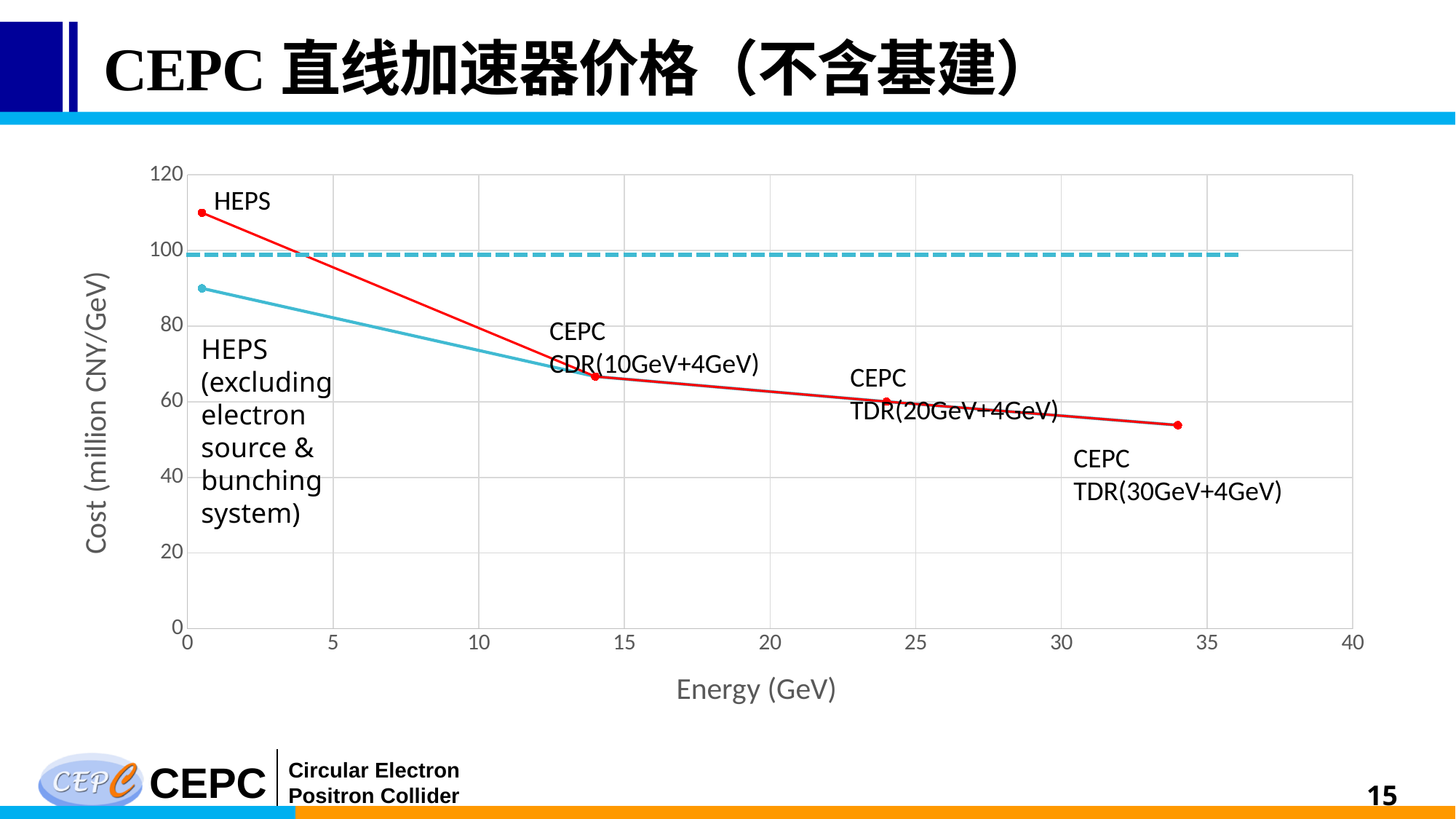
What is the title of the x axis of the chart? Energy (GeV) What is the title of the y axis of the chart? Cost (million CNY/GeV) Which has the higher cost per GeV: HEPS or HEPS (excluding electron source & bunching system)? HEPS Which labelled point has the lowest cost per GeV? CEPC TDR(30GeV+4GeV) Does the cost per GeV rise or fall as energy increases along the x axis? fall Is the cost value for HEPS (excluding electron source & bunching system) greater or less than 100? less What kind of chart is shown on the slide? line chart Is the cost value for CEPC CDR(10GeV+4GeV) greater or less than 80? less Is the cost value for CEPC TDR(30GeV+4GeV) greater or less than 60? less How many CEPC data points are labelled on the chart? 3 Which labelled point has the highest cost per GeV? HEPS